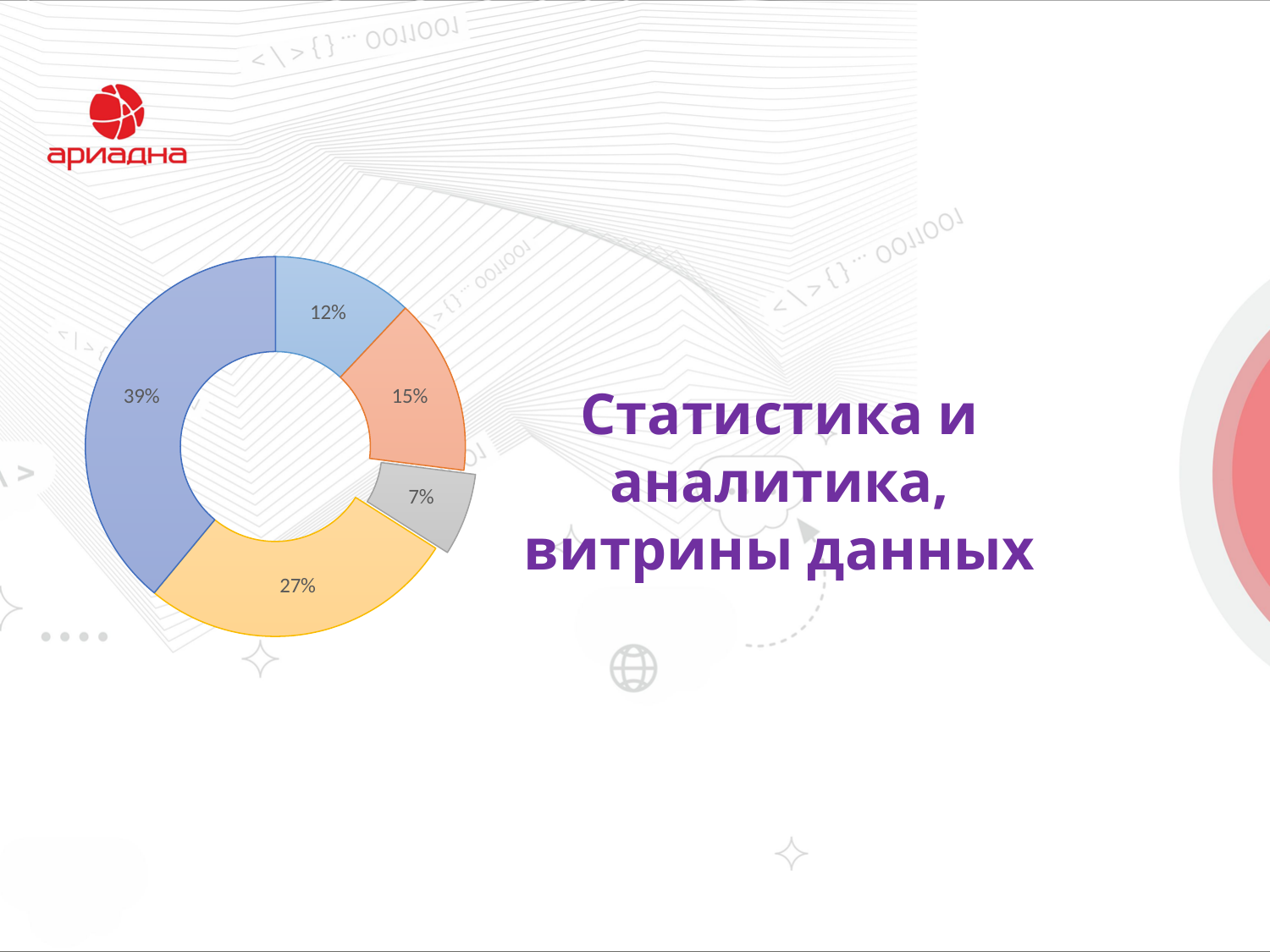
What value is shown on the gray slice of the doughnut chart? 7% What kind of chart is shown on the slide? doughnut chart How many slices does the doughnut chart have? 5 What value is shown on the yellow slice of the doughnut chart? 27% What is the combined value of the 12% and 15% slices? 27% What is the difference between the largest slice (39%) and the yellow slice (27%)? 12% What value is shown on the orange slice of the doughnut chart? 15% What is the value of the smallest slice in the doughnut chart? 7% What value is shown on the light blue slice at the top of the doughnut chart? 12% Which slice is larger, the orange one or the light blue one? the orange one (15%) What is the value of the largest slice in the doughnut chart? 39% What colour is the largest slice of the doughnut chart? blue